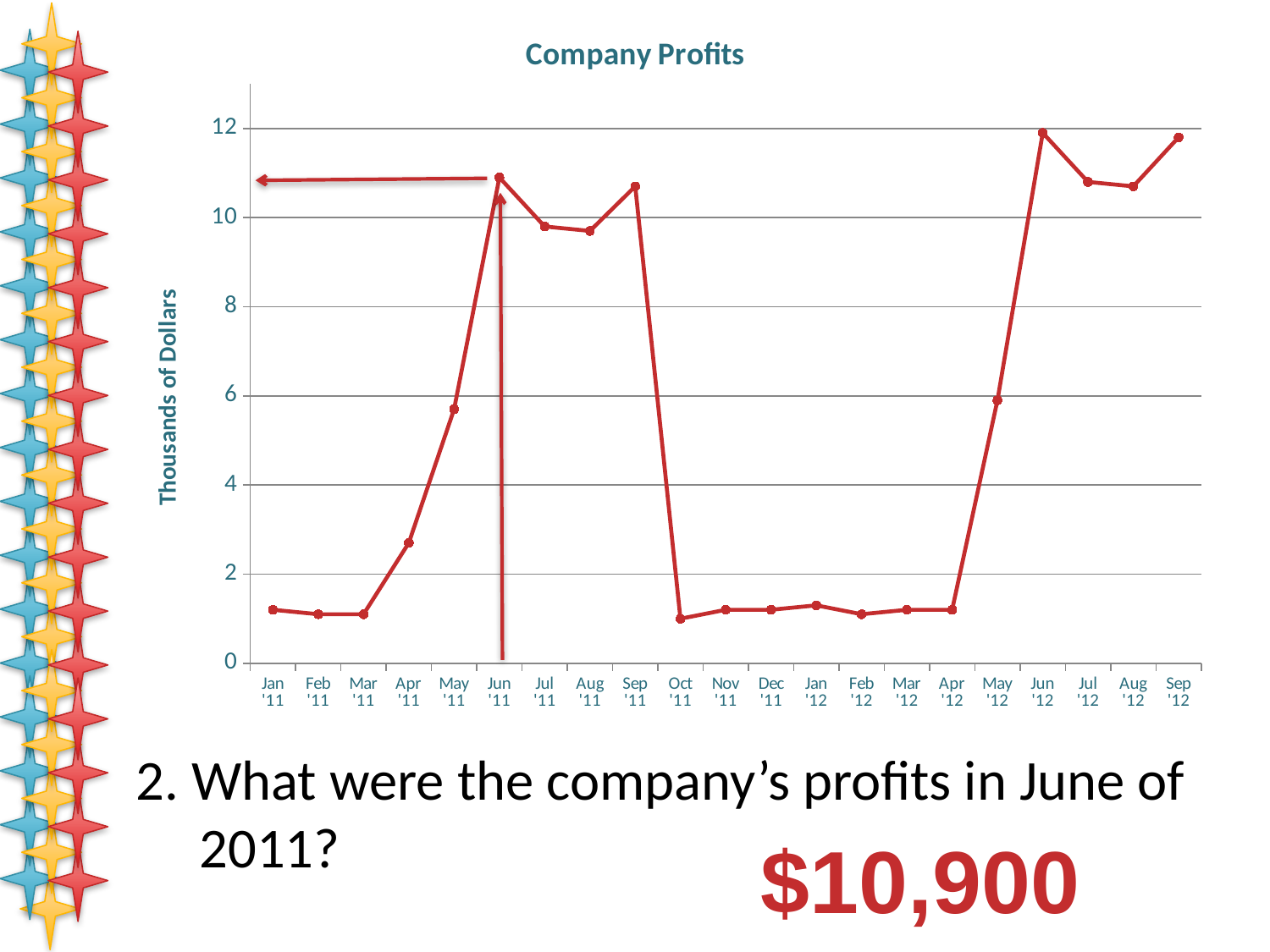
Is the value for Sep '11 greater or less than 10? greater What were the company's profits in June 2011 according to the chart? $10,900 Is the value for Jan '11 greater or less than 2? less Is the value for Oct '11 greater or less than 2? less Which is larger, the value for Sep '11 or the value for Dec '11? Sep '11 How many months are plotted on the chart? 21 Do the values rise or fall from Jan '11 to Jun '11? rise Which is larger, the value for Apr '11 or the value for Apr '12? Apr '11 What is the title of the chart? Company Profits What kind of chart is shown on the slide? line chart What is the label on the vertical axis of the chart? Thousands of Dollars